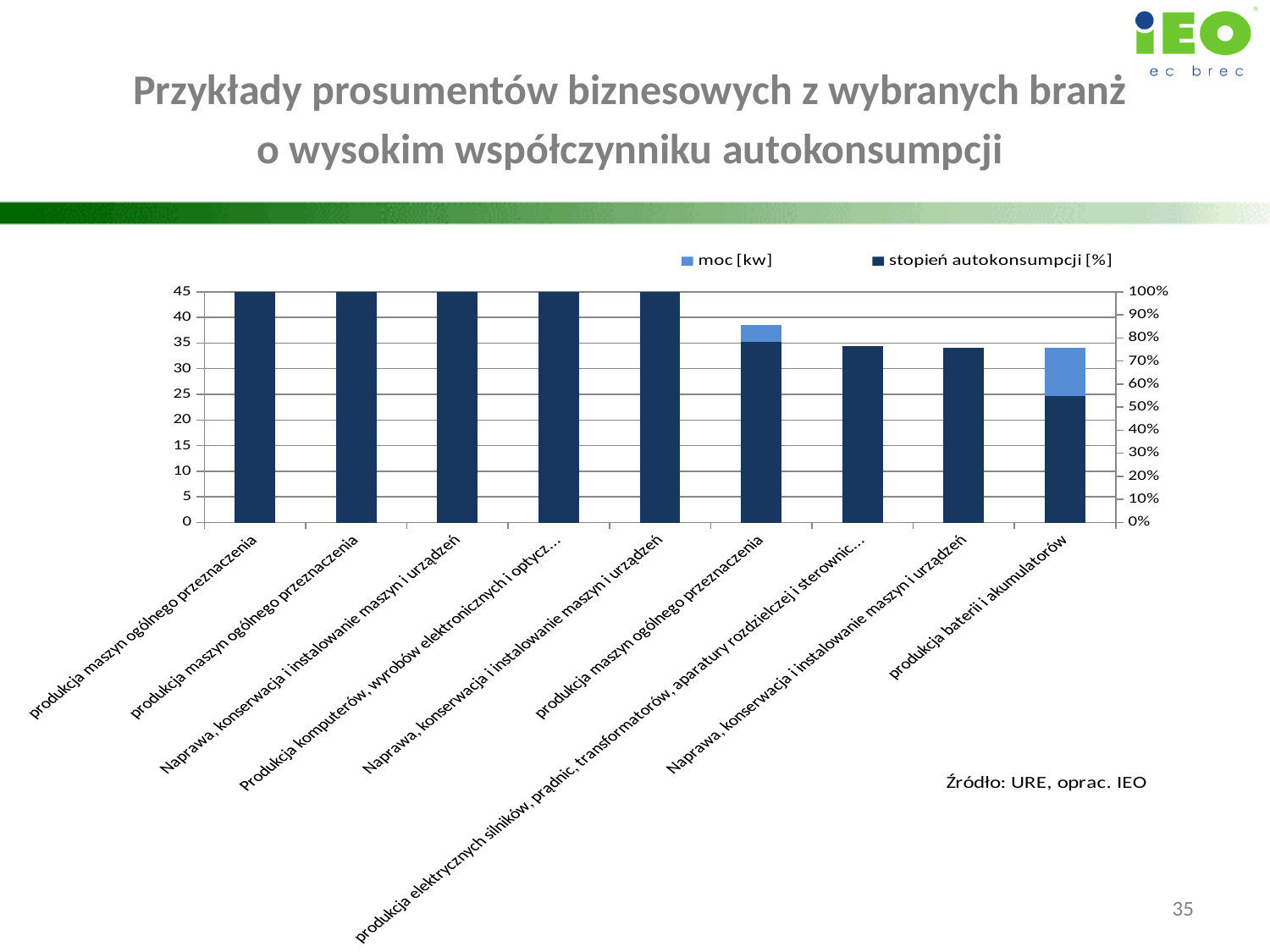
Is the stopień autokonsumpcji [%] value for the eighth category from the left (Naprawa, konserwacja i instalowanie maszyn i urządzeń) greater or less than 80%? less What are the two series named in the chart legend? moc [kw] and stopień autokonsumpcji [%] Is the moc [kw] value for produkcja baterii i akumulatorów greater or less than 30? greater How many series does the chart legend list? 2 Which category has the lowest stopień autokonsumpcji [%] in the chart? produkcja baterii i akumulatorów Is the stopień autokonsumpcji [%] value for produkcja baterii i akumulatorów greater or less than 60%? less Which has the larger stopień autokonsumpcji [%]: the first category from the left (produkcja maszyn ogólnego przeznaczenia) or produkcja baterii i akumulatorów? produkcja maszyn ogólnego przeznaczenia (first from left) How many categories are plotted along the x axis of the chart? 9 What kind of chart is shown on the slide? bar chart What source is cited below the chart? Źródło: URE, oprac. IEO